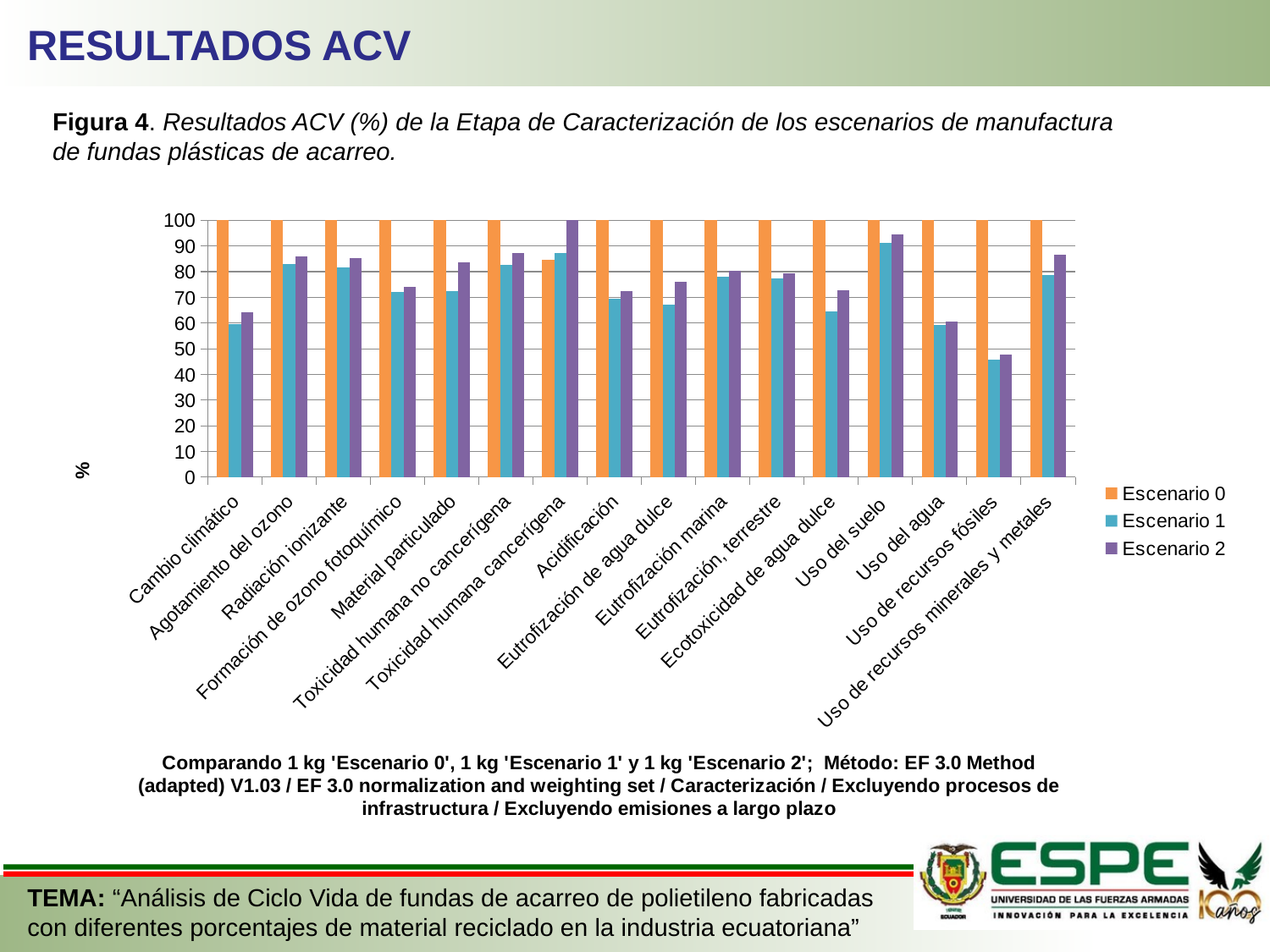
What label is shown on the y axis? % How many series does the legend list? 3 How many impact categories are shown on the x axis? 16 For Toxicidad humana cancerígena, which is larger: Escenario 0 or Escenario 2? Escenario 2 Is the value of Escenario 2 for Uso del agua greater or less than 70? less What is the value of Escenario 2 for Toxicidad humana cancerígena? 100 Is the value of Escenario 1 for Uso del suelo greater or less than 80? greater For Cambio climático, which is larger: Escenario 1 or Escenario 2? Escenario 2 What kind of chart is shown on the slide? Bar chart Is the value of Escenario 1 for Uso de recursos fósiles greater or less than 50? less Which category has the lowest value for Escenario 1? Uso de recursos fósiles What is the value of Escenario 0 for Cambio climático? 100